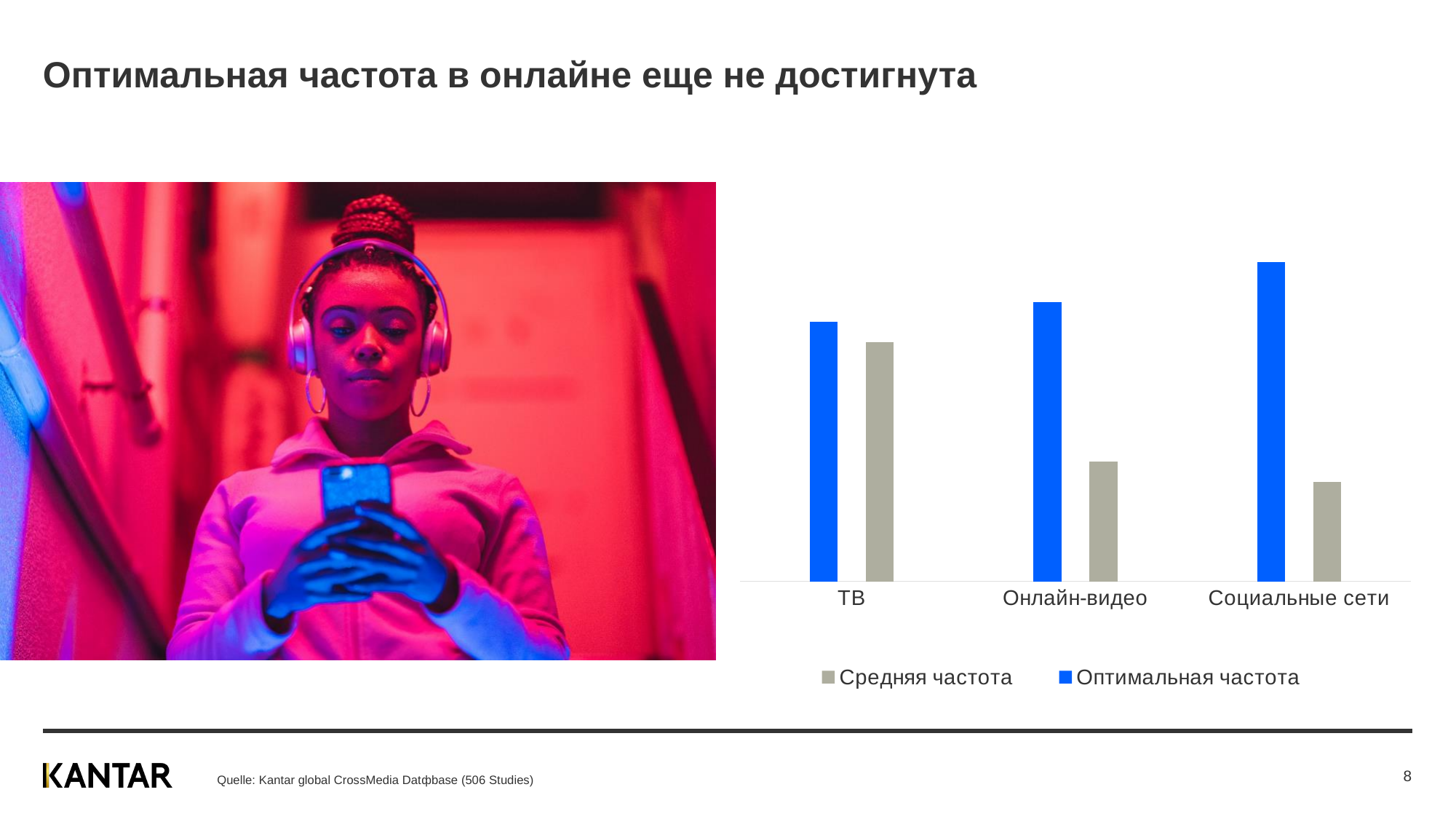
Which category has the highest value for Оптимальная частота? Социальные сети How many series does the chart legend list? 2 Do the values for Оптимальная частота rise or fall from ТВ to Социальные сети? Rise For Онлайн-видео, which is larger: Средняя частота or Оптимальная частота? Оптимальная частота Do the values for Средняя частота rise or fall from ТВ to Социальные сети? Fall Which category has the lowest value for Оптимальная частота? ТВ Which category has the highest value for Средняя частота? ТВ How many categories are shown on the x axis of the chart? 3 Which category has the lowest value for Средняя частота? Социальные сети What kind of chart is shown on the slide? Bar chart Which colour represents Средняя частота in the chart legend? Grey For Социальные сети, which is larger: Средняя частота or Оптимальная частота? Оптимальная частота